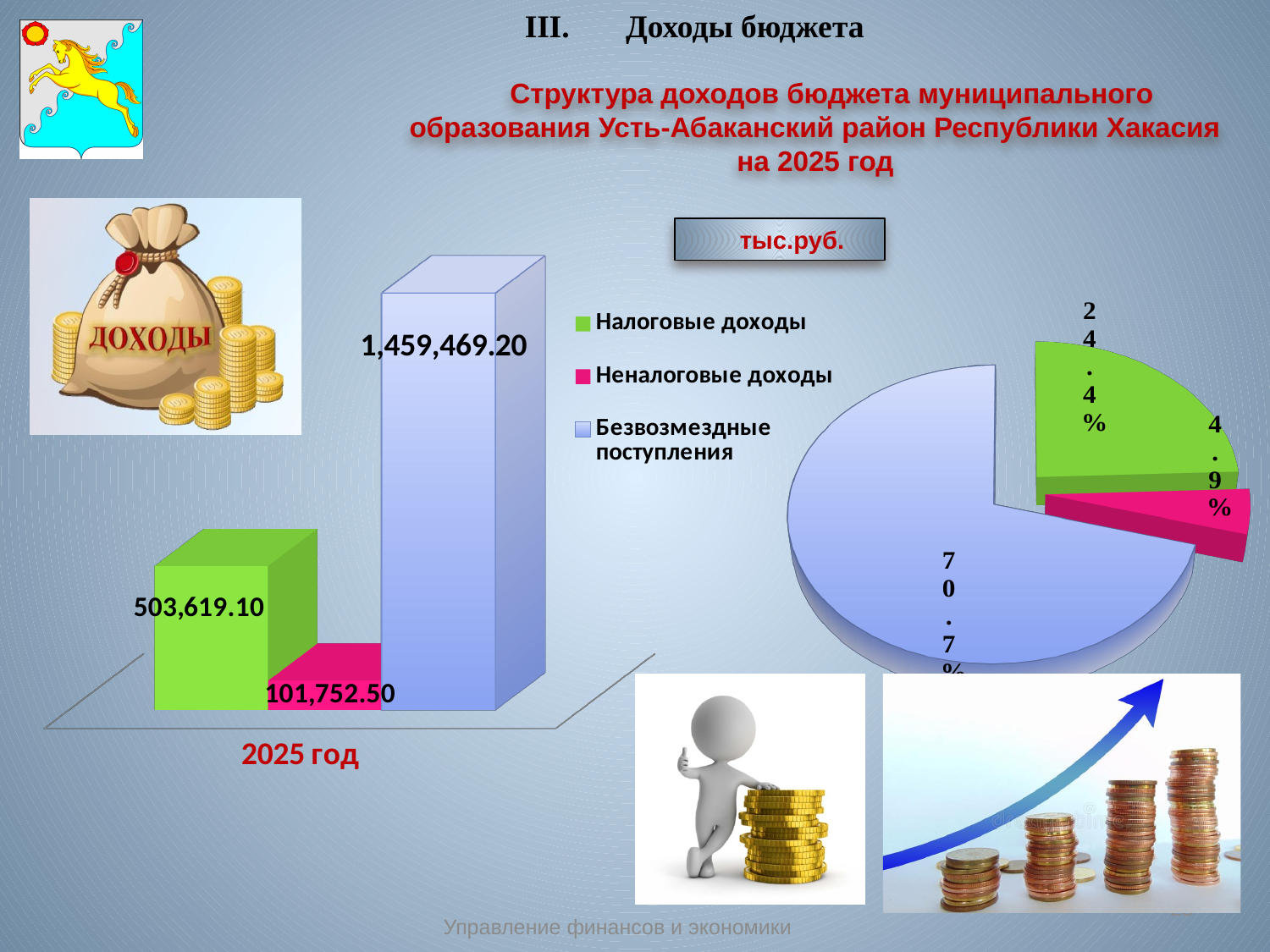
On the pie chart, what share is shown for the green slice (Налоговые доходы)? 24.4% On the bar chart, which series has the lowest value? Неналоговые доходы On the bar chart, which series has the highest value? Безвозмездные поступления On the bar chart, what is the value for Безвозмездные поступления? 1,459,469.20 On the bar chart, which is larger: Налоговые доходы or Безвозмездные поступления? Безвозмездные поступления On the bar chart, what is the difference between Налоговые доходы and Неналоговые доходы? 401,866.60 What kind of chart is the chart on the right side of the slide? Pie chart On the pie chart, what share is shown for the pink slice (Неналоговые доходы)? 4.9% How many series does the legend list? 3 On the bar chart, what is the value for Неналоговые доходы? 101,752.50 On the bar chart, what is the value for Налоговые доходы? 503,619.10 What kind of chart is the chart on the left side of the slide? Bar chart